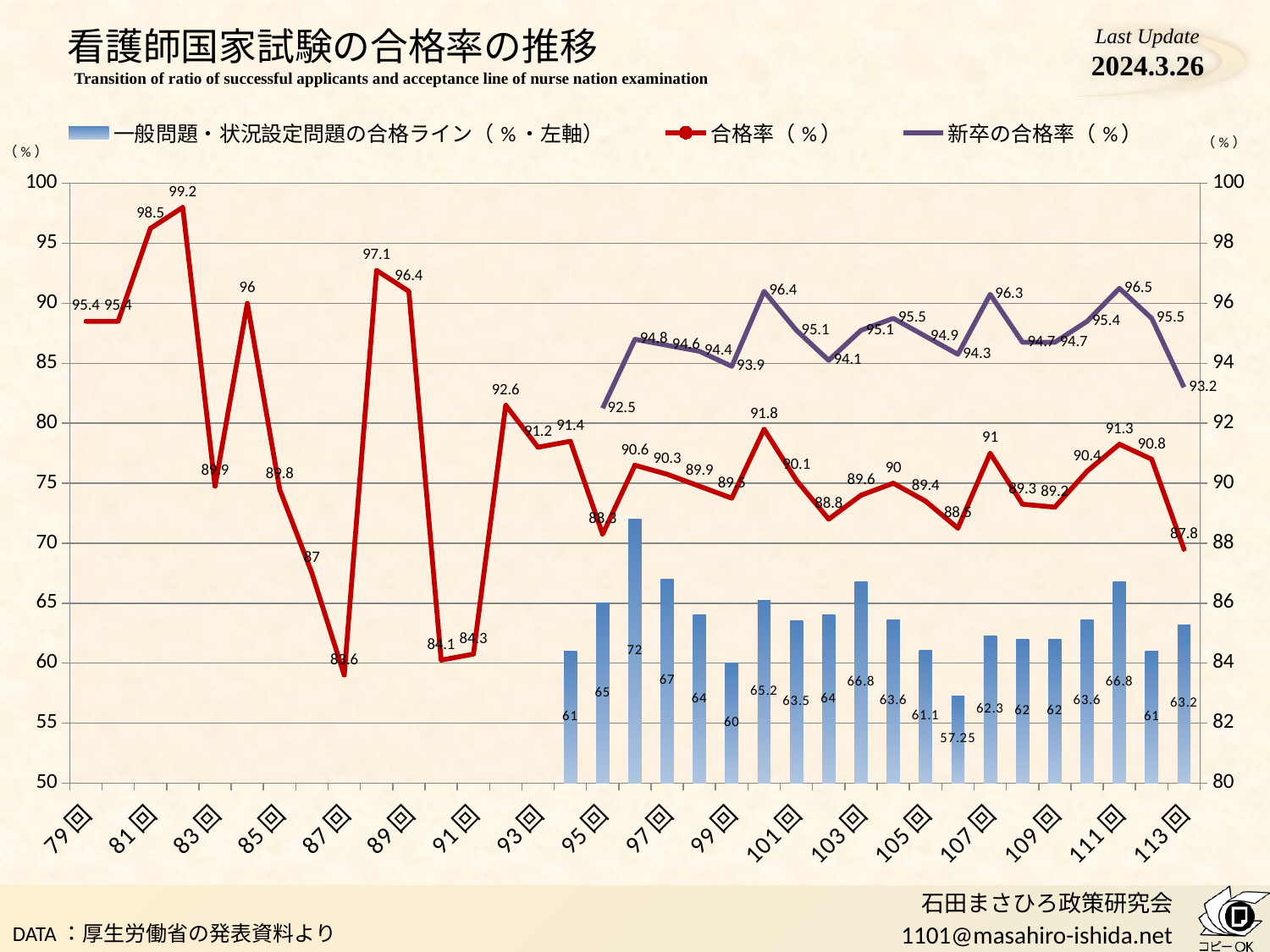
What is the highest value among the bars (合格ライン)? 72 What is the 合格率 (%) value at 113回? 87.8 What is the lowest value labeled on the 合格率 (%) line? 83.6 What is the difference between the 新卒の合格率 and the 合格率 at 113回? 5.4 What kind of chart is shown on the slide? Combined bar and line chart Which is larger, the 合格率 at 111回 or at 113回? 111回 What is the lowest value among the bars (合格ライン)? 57.25 What is the highest value labeled on the 新卒の合格率 (%) line? 96.5 What is the lowest value labeled on the 新卒の合格率 (%) line? 92.5 How many series does the legend list? 3 What is the highest value labeled on the 合格率 (%) line? 99.2 What is the 新卒の合格率 (%) value at 113回? 93.2